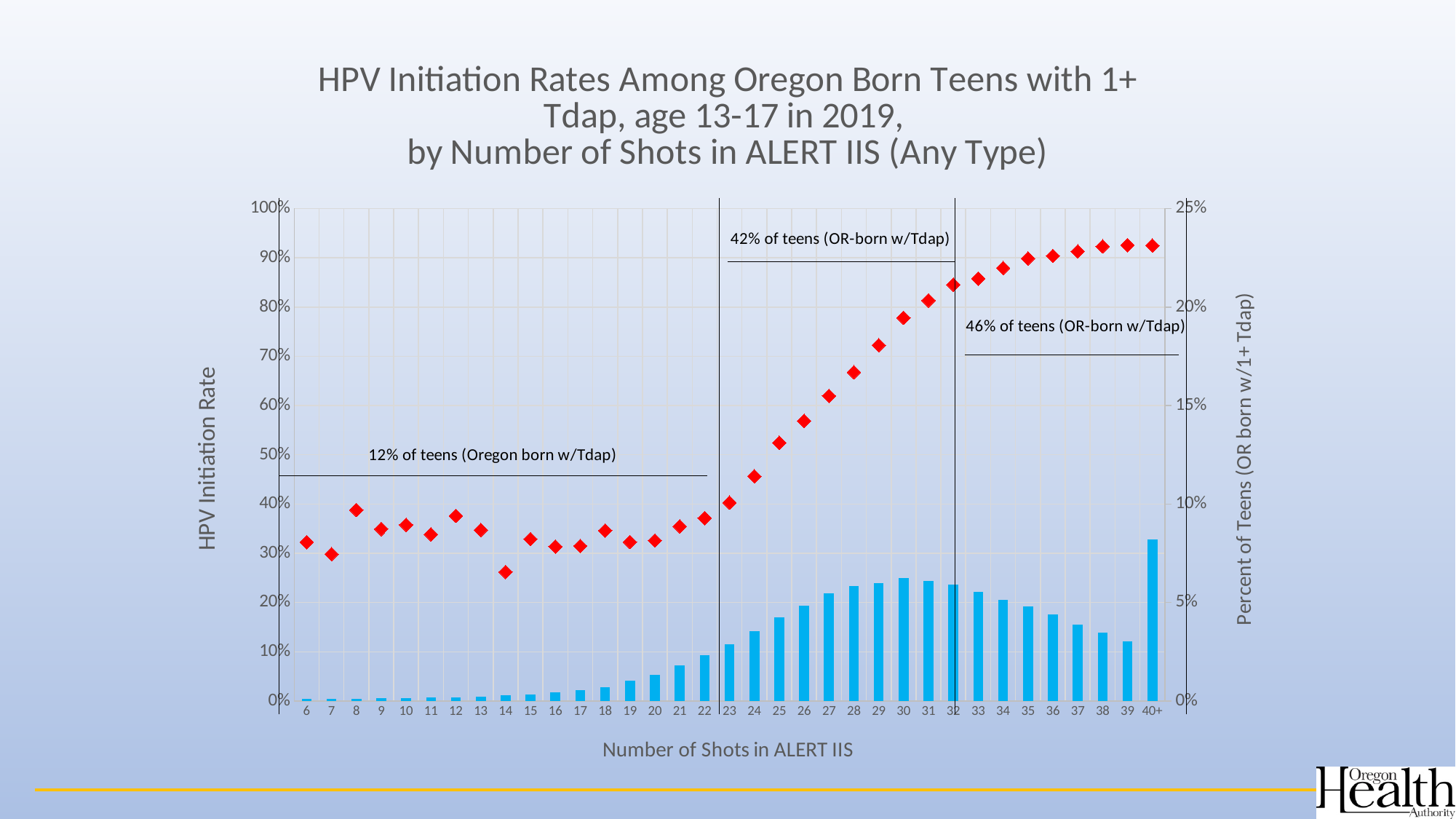
What is the title of the left y axis? HPV Initiation Rate How many shot-count categories are shown on the x axis? 35 Which shot-count category has the highest Percent of Teens bar? 40+ Is the HPV Initiation Rate for 30 shots greater or less than 70%? greater What is the title of the x axis? Number of Shots in ALERT IIS Which shot-count category has the lowest HPV Initiation Rate? 14 What kind of chart is used to plot the Percent of Teens series? bar chart Which has a higher HPV Initiation Rate, 7 shots or 8 shots? 8 shots According to the annotation, what percent of teens fall in the 23 to 32 shots group? 42% of teens Does the HPV Initiation Rate rise or fall as the number of shots increases from 23 to 40+? rise Is the Percent of Teens for 23 shots greater or less than 5%? less According to the annotation, what percent of teens fall in the 6 to 22 shots group? 12% of teens